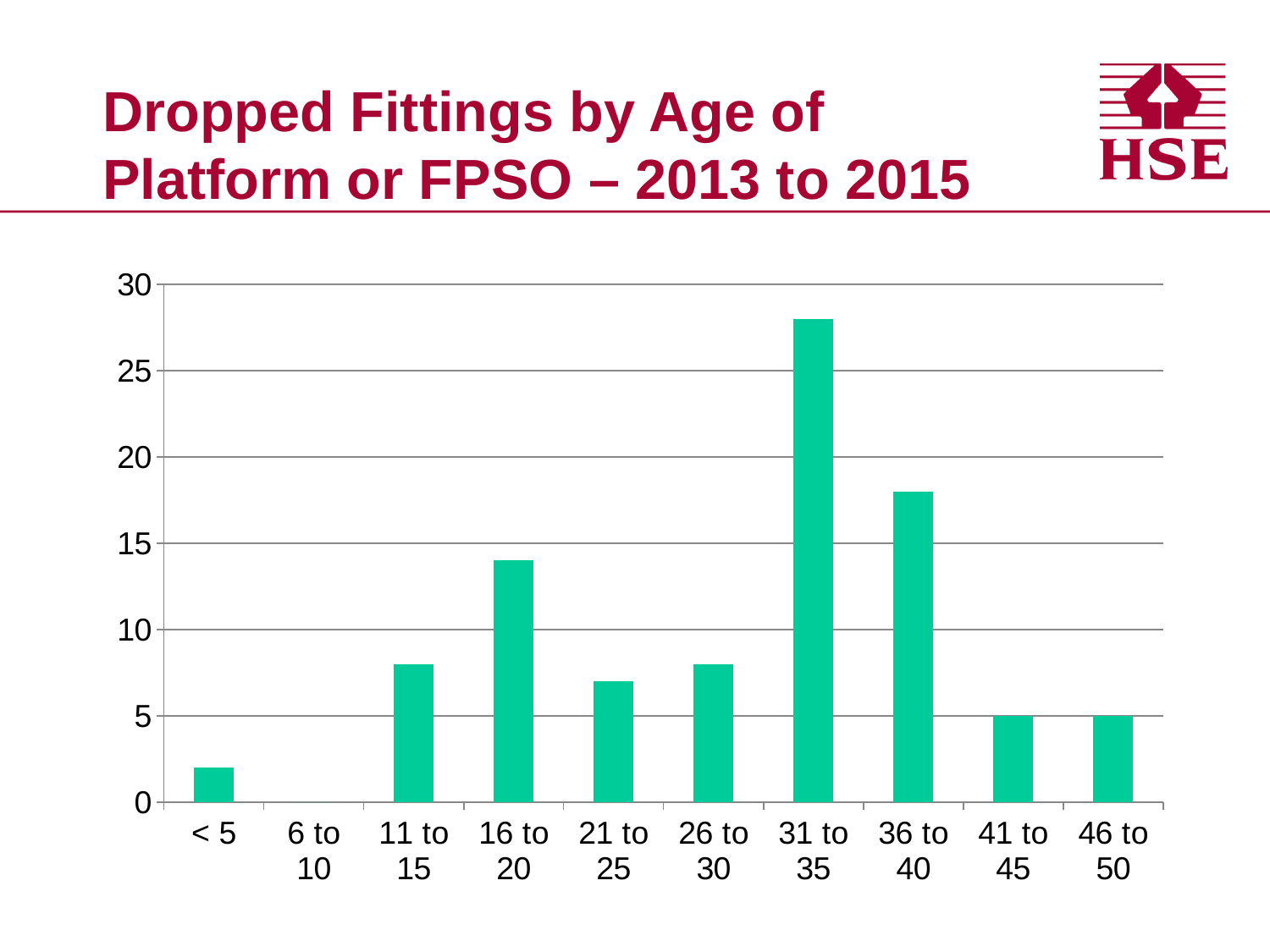
Is the value for the < 5 age category greater or less than 5? less Which age category has the highest number of dropped fittings? 31 to 35 What kind of chart is shown on the slide? bar chart What is the value for the 6 to 10 age category? 0 Which has the larger value, the 31 to 35 category or the 36 to 40 category? 31 to 35 What is the value for the 46 to 50 age category? 5 Which age category has the lowest number of dropped fittings? 6 to 10 What is the value for the 41 to 45 age category? 5 Is the value for the 31 to 35 age category greater or less than 25? greater How many age categories are shown on the x axis? 10 What is the title of the slide containing the chart? Dropped Fittings by Age of Platform or FPSO – 2013 to 2015 Is the value for the 16 to 20 age category greater or less than 10? greater